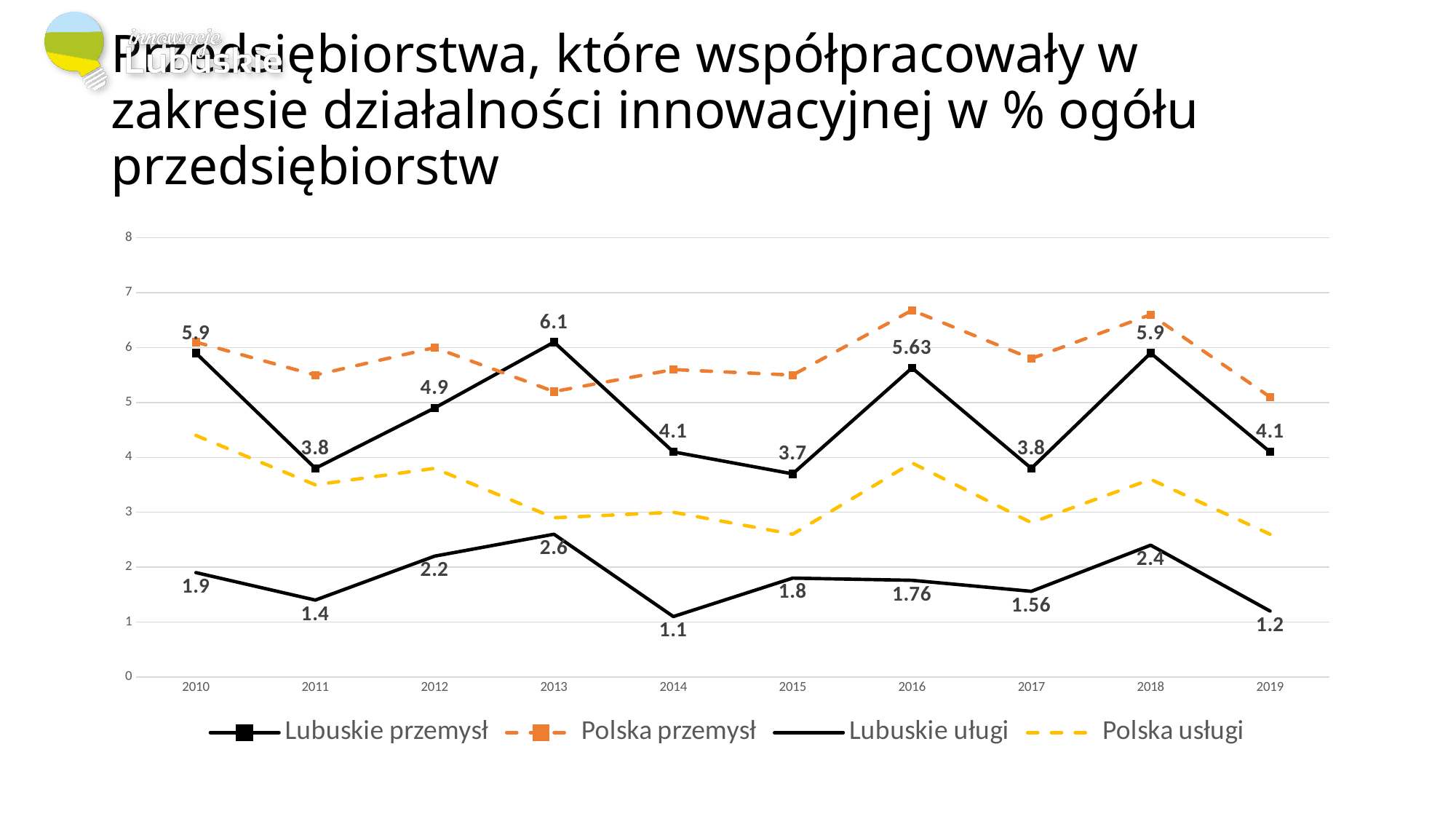
How many years are shown on the x axis? 10 What is the value for Lubuskie przemysł in 2013? 6.1 How many series does the legend list? 4 In which year is the Lubuskie usługi series at its lowest? 2014 What is the value for Lubuskie usługi in 2017? 1.56 In which year is the Lubuskie przemysł series at its highest? 2013 Which is larger: the Lubuskie usługi value in 2018 or in 2019? 2018 Is the value for Polska przemysł in 2016 greater or less than 6? greater What is the value for Lubuskie przemysł in 2016? 5.63 What type of chart is shown on the slide? line chart What is the difference between the Lubuskie przemysł values in 2013 and 2014? 2 Is the value for Polska usługi in 2015 greater or less than 3? less